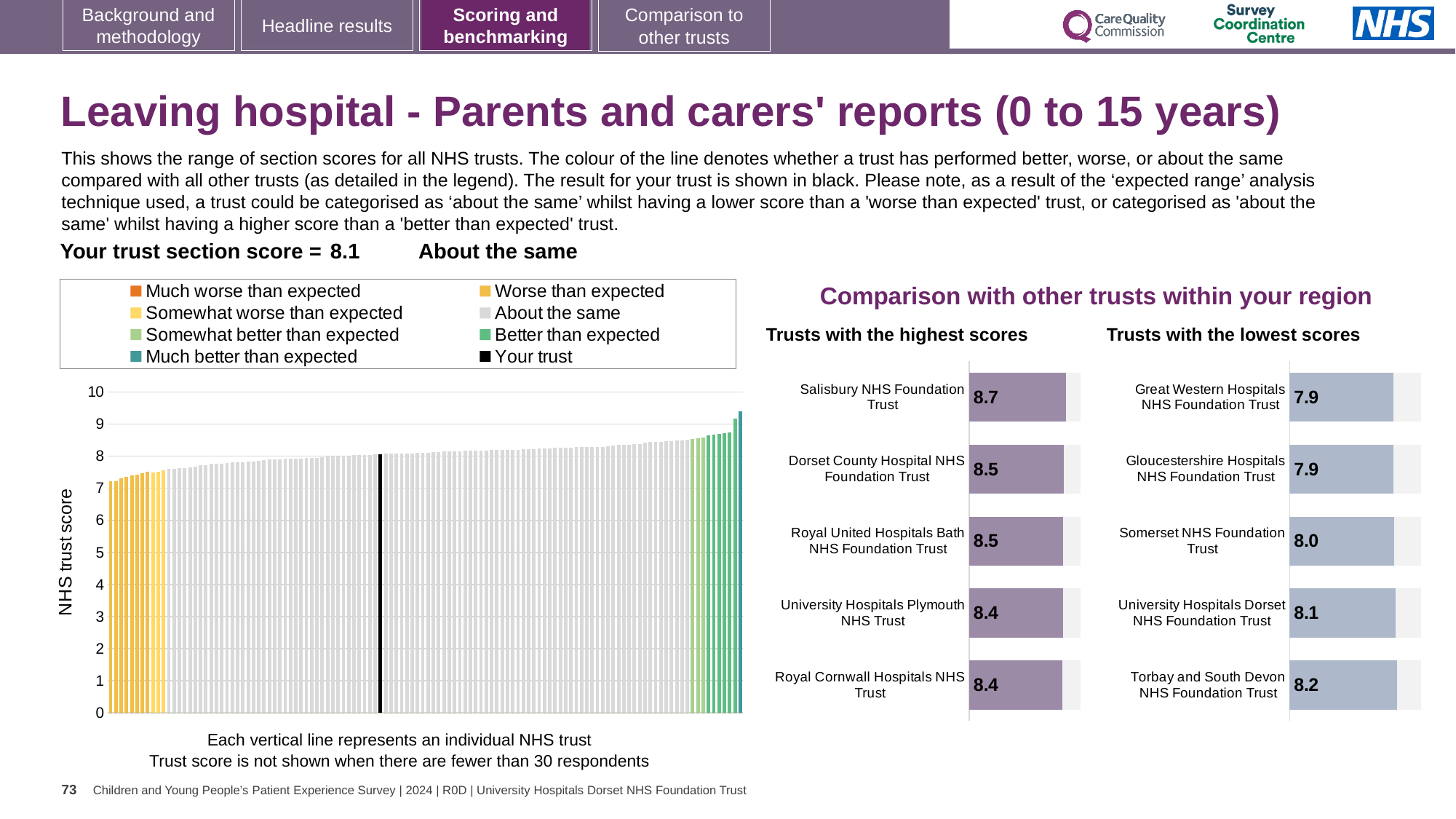
In the 'Trusts with the lowest scores' chart, what is the score for Somerset NHS Foundation Trust? 8.0 In the 'Trusts with the lowest scores' chart, what is the difference between the scores of Torbay and South Devon NHS Foundation Trust and Great Western Hospitals NHS Foundation Trust? 0.3 In the large 'NHS trust score' chart on the left, how many entries does the legend list? 8 In the 'Trusts with the lowest scores' chart, which has the larger score: Somerset NHS Foundation Trust or Torbay and South Devon NHS Foundation Trust? Torbay and South Devon NHS Foundation Trust In the 'Trusts with the lowest scores' chart, which trust has the highest score shown? Torbay and South Devon NHS Foundation Trust In the 'Trusts with the highest scores' chart, how many trusts are listed? 5 What kind of chart is the large 'NHS trust score' chart on the left? Bar chart In the 'Trusts with the highest scores' chart, which trust has the highest score? Salisbury NHS Foundation Trust In the 'Trusts with the highest scores' chart, what is the difference between the scores of Salisbury NHS Foundation Trust and Royal Cornwall Hospitals NHS Trust? 0.3 In the large 'NHS trust score' chart on the left, do the bar values rise or fall from left to right? Rise In the 'Trusts with the highest scores' chart, what is the score for Salisbury NHS Foundation Trust? 8.7 In the large 'NHS trust score' chart on the left, is the value of the rightmost bar greater or less than 9? greater